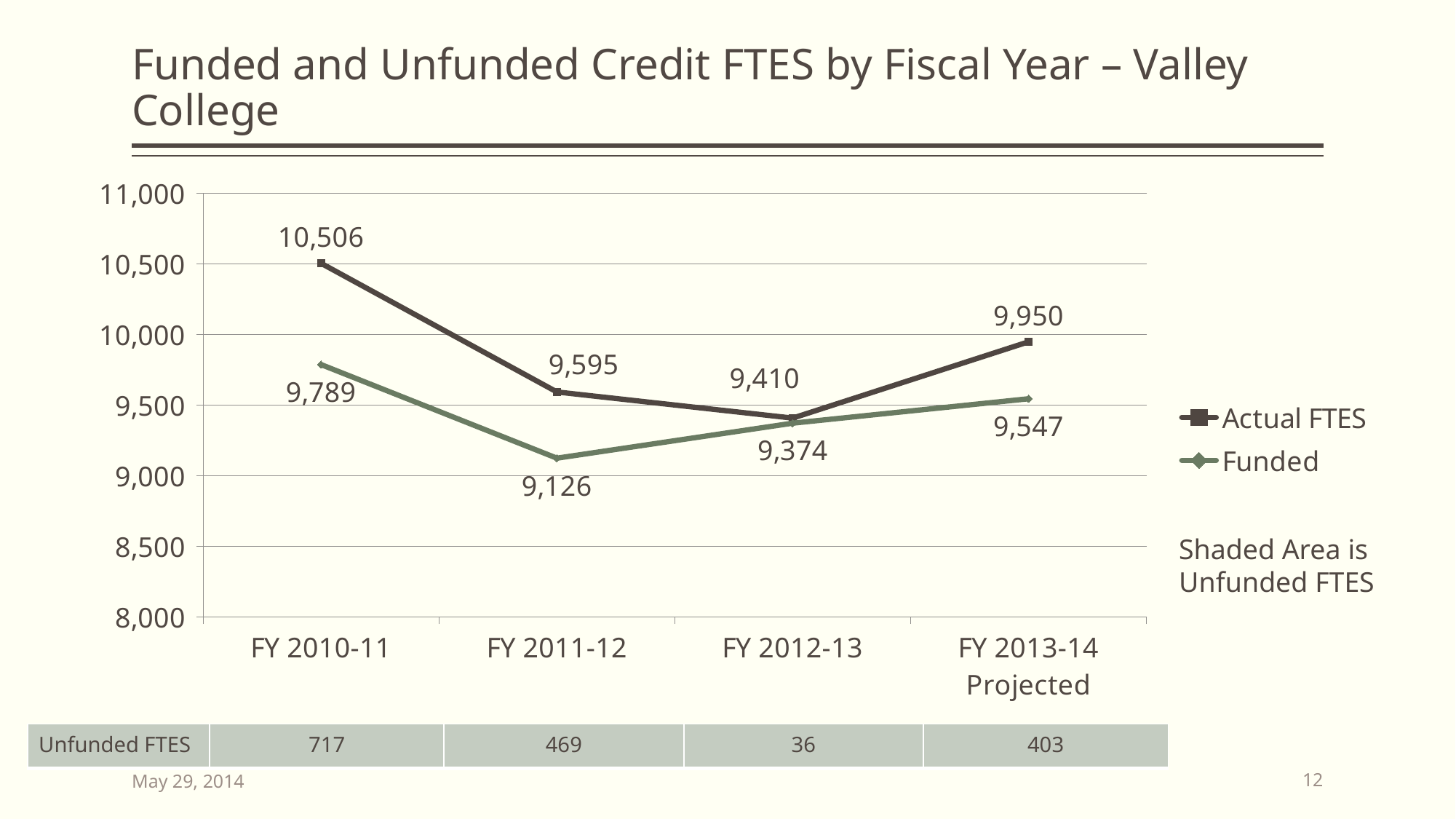
Which is larger in FY 2013-14 Projected, Actual FTES or Funded? Actual FTES What kind of chart is shown on the slide? Line chart In which fiscal year is the Funded value the lowest? FY 2011-12 What is the Funded value for FY 2011-12? 9,126 What is the Actual FTES value for FY 2010-11? 10,506 How many series does the legend list? 2 In which fiscal year is Actual FTES the highest? FY 2010-11 How many fiscal years are plotted on the x axis? 4 Does the Actual FTES series rise or fall from FY 2010-11 to FY 2012-13? Fall What is the Actual FTES value for FY 2013-14 Projected? 9,950 What is the Funded value for FY 2012-13? 9,374 What is the difference between Actual FTES and Funded in FY 2010-11? 717